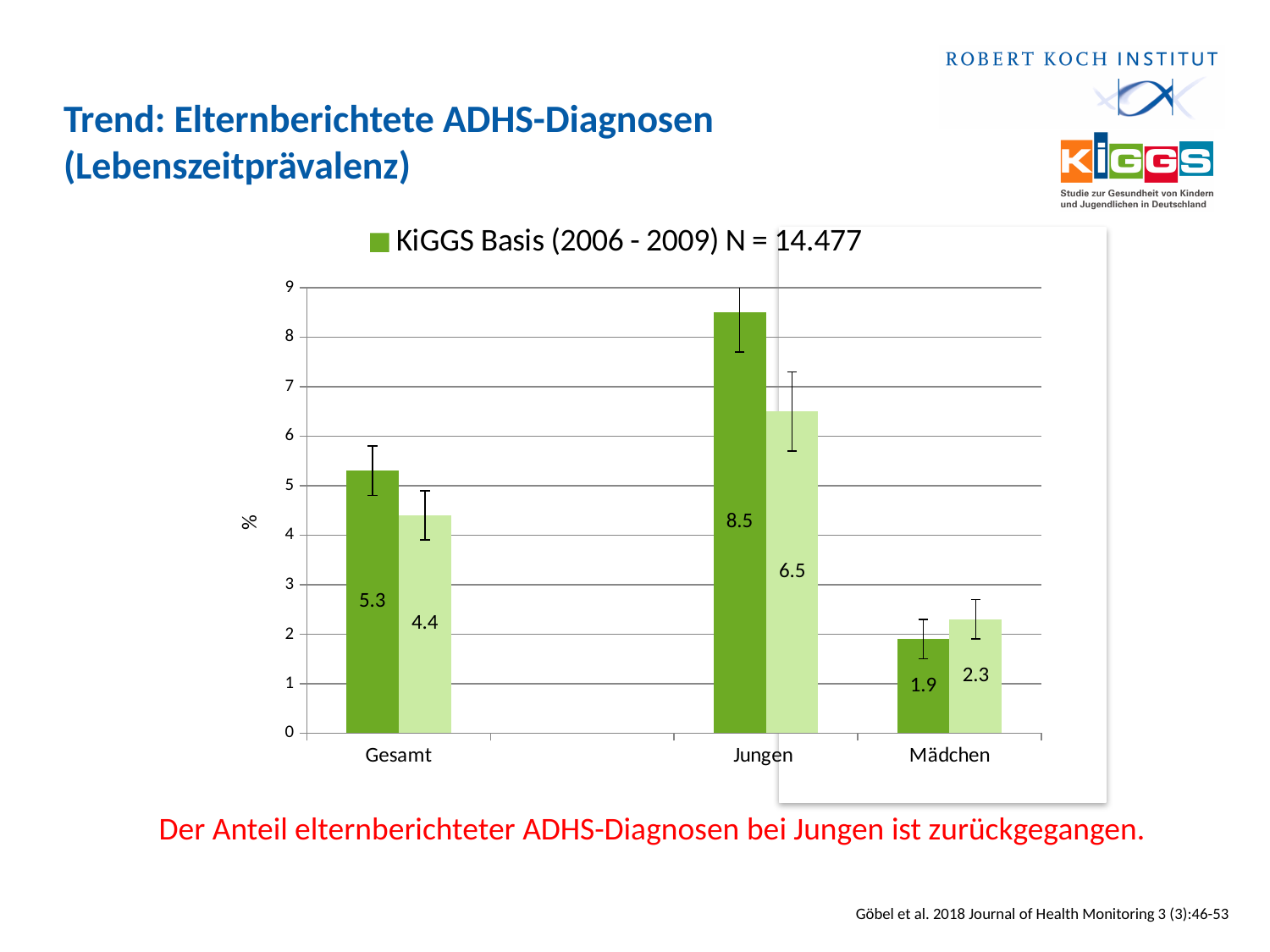
What is the difference between the KiGGS Basis (2006 - 2009) value and the light green value for Jungen? 2.0 What is the value of the KiGGS Basis (2006 - 2009) bar for Mädchen? 1.9 What is the value of the light green bar for Jungen? 6.5 What is the label of the y axis? % Which category has the highest value in the KiGGS Basis (2006 - 2009) series? Jungen For Mädchen, which bar is larger: the KiGGS Basis (2006 - 2009) bar or the light green bar? the light green bar What is the value of the KiGGS Basis (2006 - 2009) bar for Jungen? 8.5 What type of chart is shown on the slide? bar chart How many categories are shown on the x axis? 3 What is the value of the KiGGS Basis (2006 - 2009) bar for Gesamt? 5.3 Which category has the lowest value among the light green bars? Mädchen What is the value of the light green bar for Mädchen? 2.3